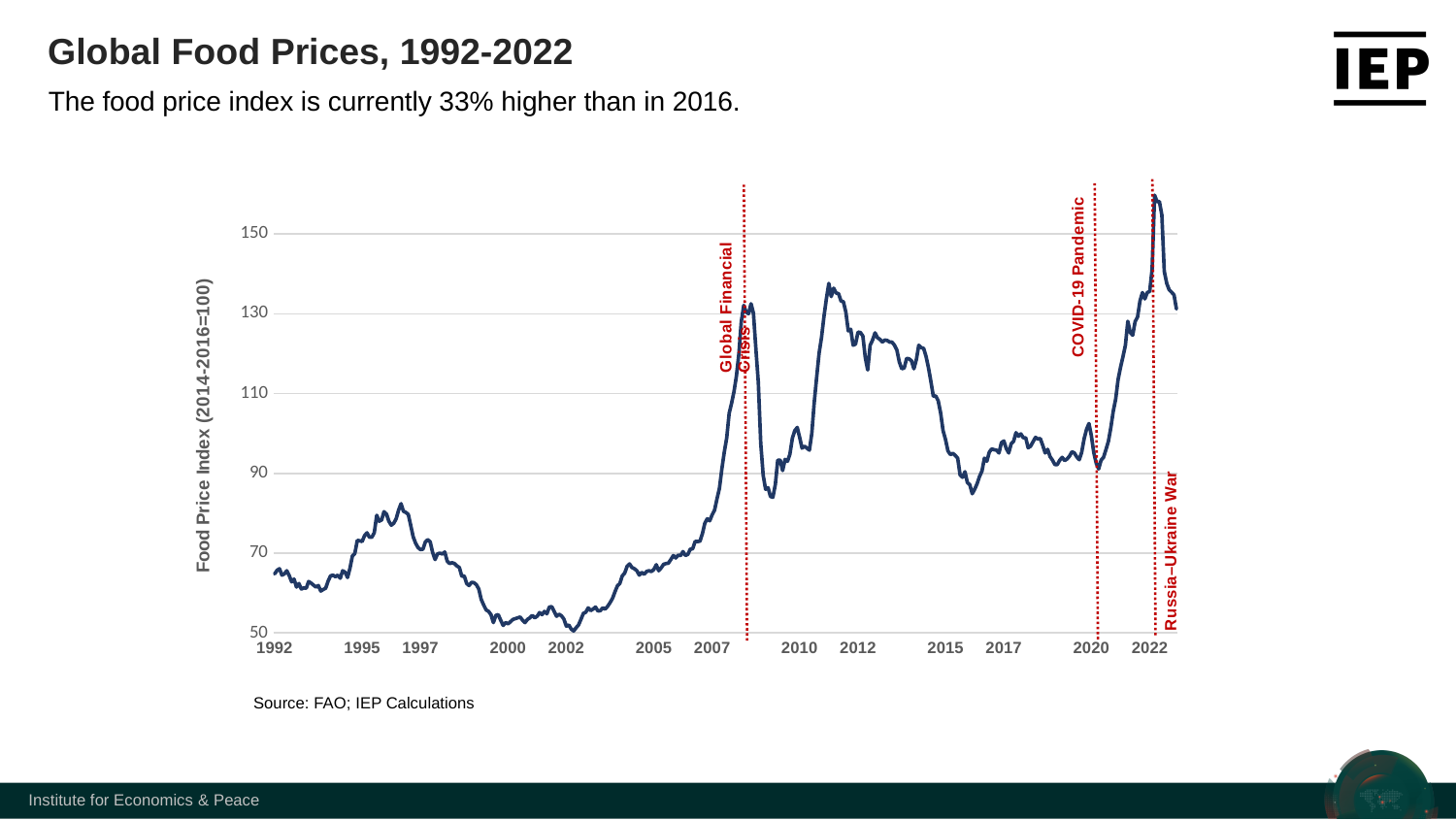
Is the peak food price index value reached in 2022 greater or less than 150? greater Is the food price index value in 2000 greater or less than 90? less Is the food price index higher in 2012 or in 2002? 2012 Is the food price index value at the start of 2020 greater or less than 110? less Does the food price index rise or fall between 2002 and 2008? rise What is the label on the y-axis of the chart? Food Price Index (2014-2016=100) Which three events are marked with dotted vertical lines on the chart? Global Financial Crisis, COVID-19 Pandemic, Russia–Ukraine War What kind of chart is shown on the slide? line chart In which year does the food price index reach its highest peak on the chart? 2022